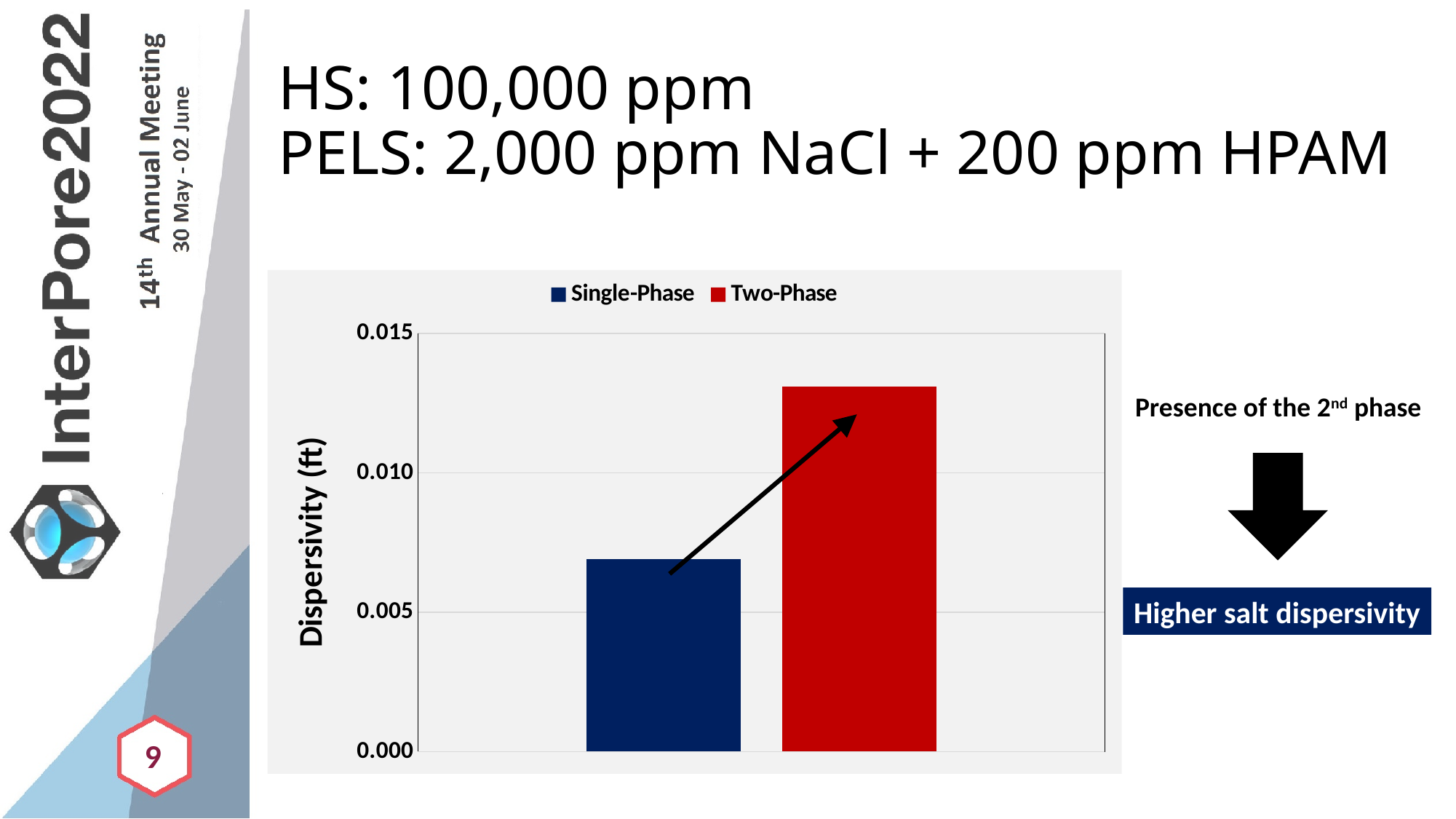
What colour is the Two-Phase bar in the chart? red What kind of chart is shown on the slide? bar chart Is the dispersivity for Two-Phase greater or less than 0.015? less Is the dispersivity for Single-Phase greater or less than 0.010? less What is the label of the vertical axis of the chart? Dispersivity (ft) Which series has the highest dispersivity? Two-Phase Is the dispersivity for Two-Phase greater or less than 0.010? greater Which series has the lowest dispersivity? Single-Phase How many bars are plotted in the chart? 2 Which series has the higher dispersivity, Single-Phase or Two-Phase? Two-Phase How many series does the chart legend list? 2